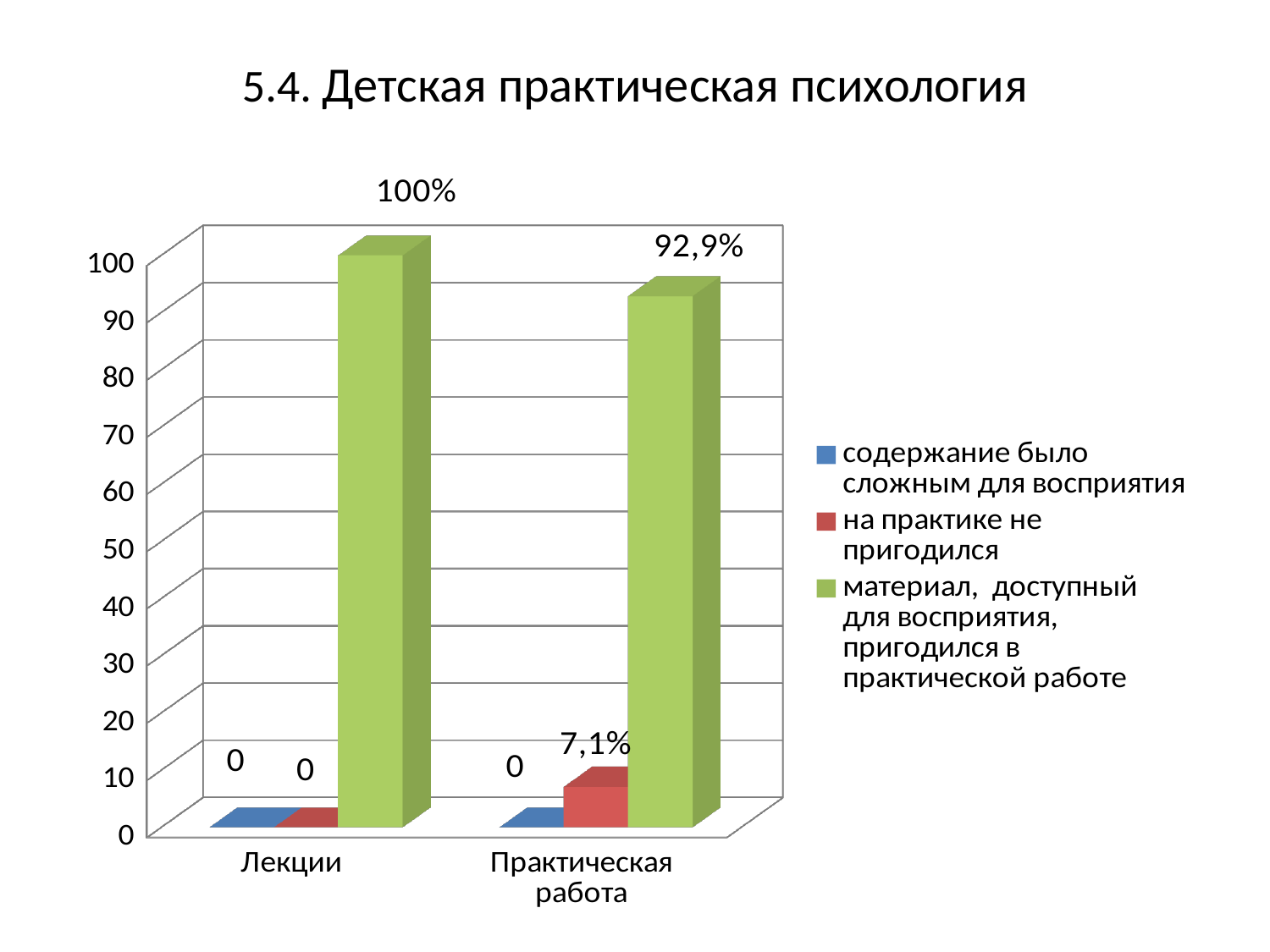
What is the value for "на практике не пригодился" for Практическая работа? 7,1% How many series does the legend list? 3 How many categories are shown on the x axis? 2 What is the value for "материал, доступный для восприятия, пригодился в практической работе" for Лекции? 100% What is the title of the slide? 5.4. Детская практическая психология What is the value for "на практике не пригодился" for Лекции? 0 Which category has the higher value for "материал, доступный для восприятия, пригодился в практической работе"? Лекции Which series has the highest value for Практическая работа? материал, доступный для восприятия, пригодился в практической работе What is the difference between the "материал, доступный для восприятия, пригодился в практической работе" values for Лекции and Практическая работа? 7,1% What kind of chart is shown on the slide? bar chart What is the value for "материал, доступный для восприятия, пригодился в практической работе" for Практическая работа? 92,9% What is the value for "содержание было сложным для восприятия" for Лекции? 0